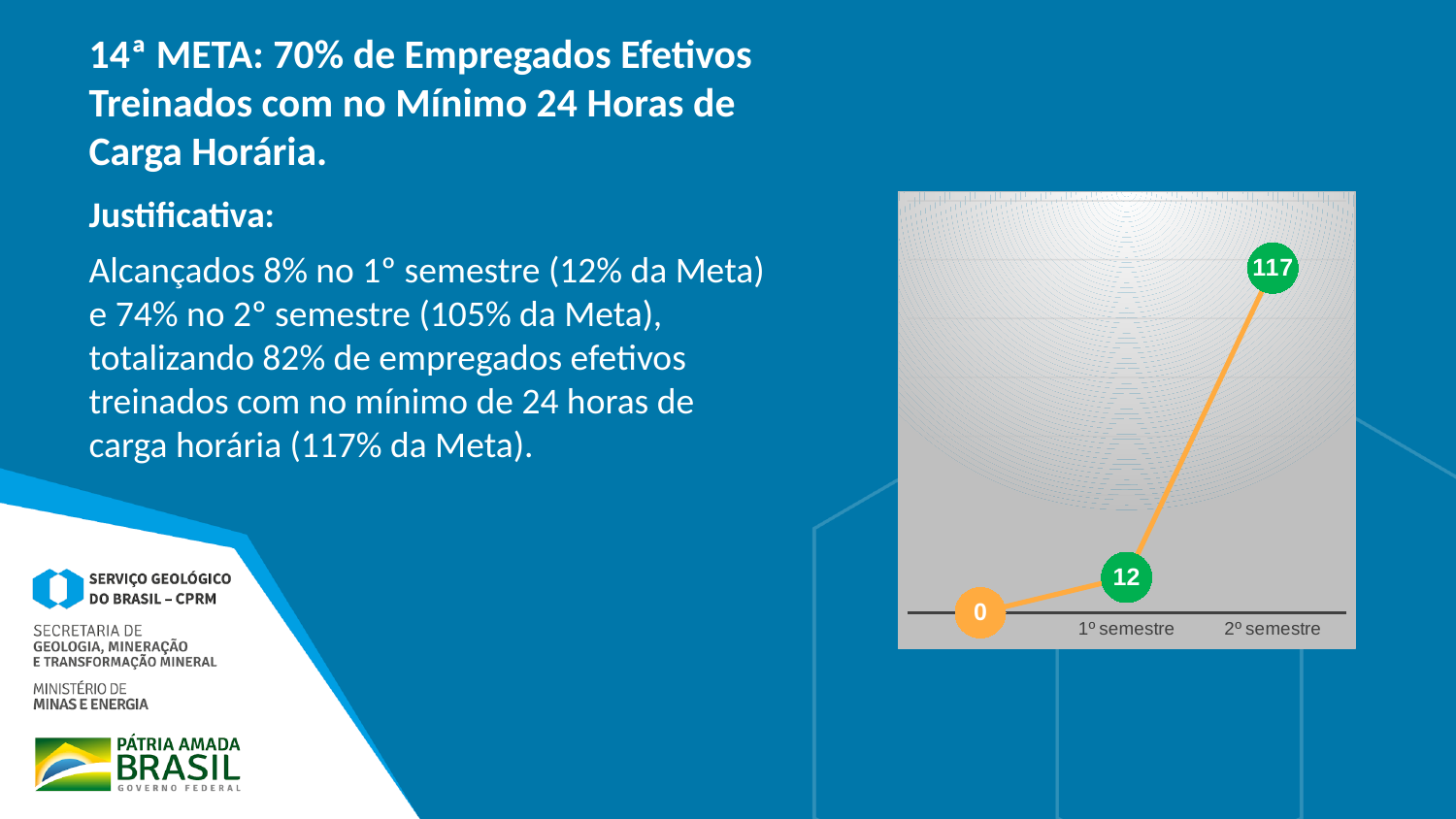
Which labelled semester has the highest value? 2º semestre What is the value plotted for 2º semestre? 117 Which labelled semester has the lowest value? 1º semestre What is the value of the first (starting) point on the line? 0 How many data points are plotted on the line? 3 What is the value plotted for 1º semestre? 12 What colour is the line connecting the points? orange What is the difference between the values for 2º semestre and 1º semestre? 105 Do the values rise or fall from left to right along the line? rise What type of chart is shown on the slide? line chart Which is larger, the value for 1º semestre or the value for 2º semestre? 2º semestre How many category labels are shown on the x axis? 2